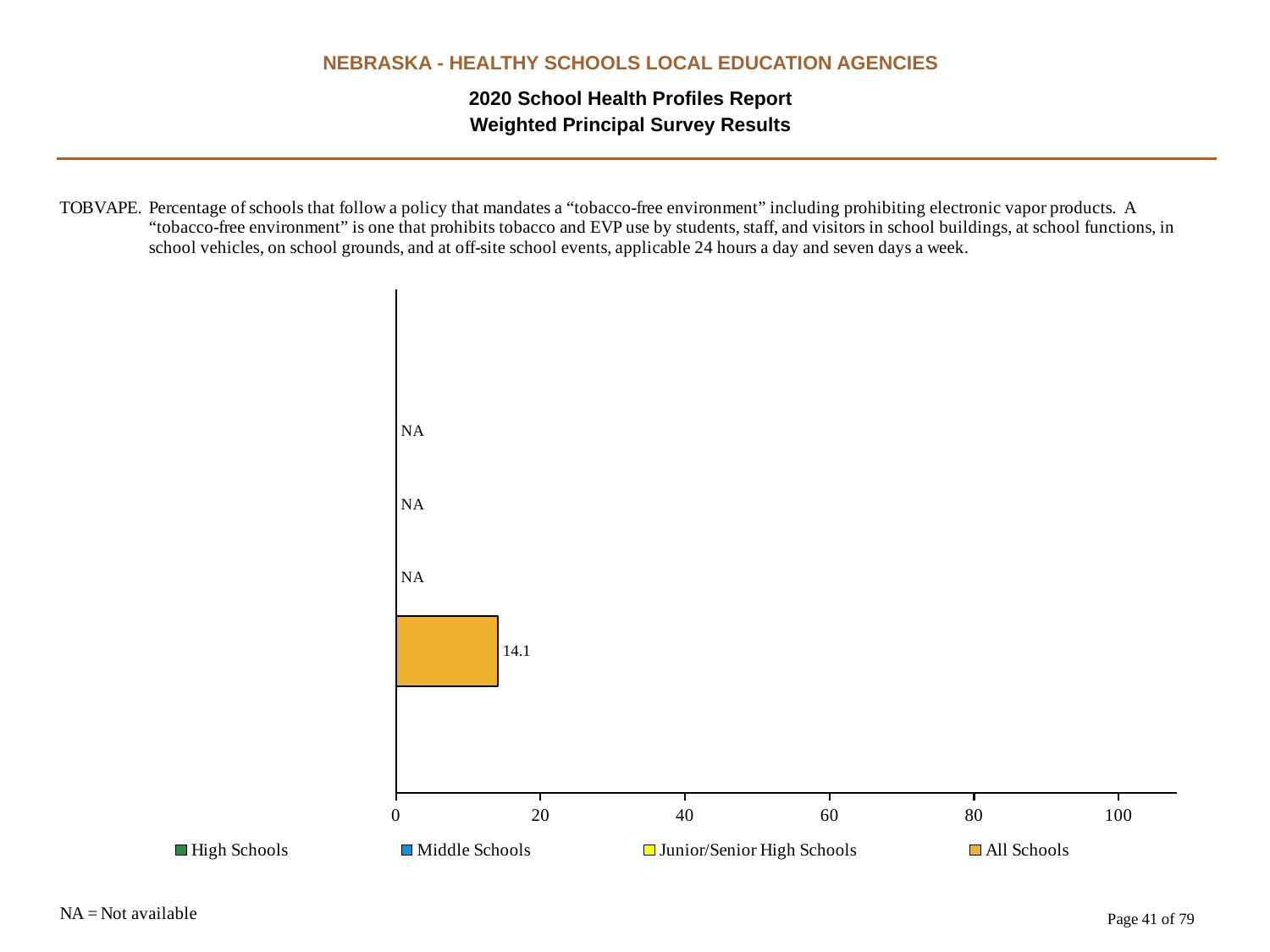
According to the note on the slide, what does NA stand for? Not available What value is shown for High Schools? NA How many series does the legend list? 4 Which school group is the only one with a plotted value? All Schools How many of the school groups have a plotted bar rather than NA? 1 What value is shown for Junior/Senior High Schools? NA What is the maximum value shown on the x axis? 100 What is the value for All Schools? 14.1 What value is shown for Middle Schools? NA Is the value for All Schools greater or less than 20? less What kind of chart is shown on the slide? bar chart